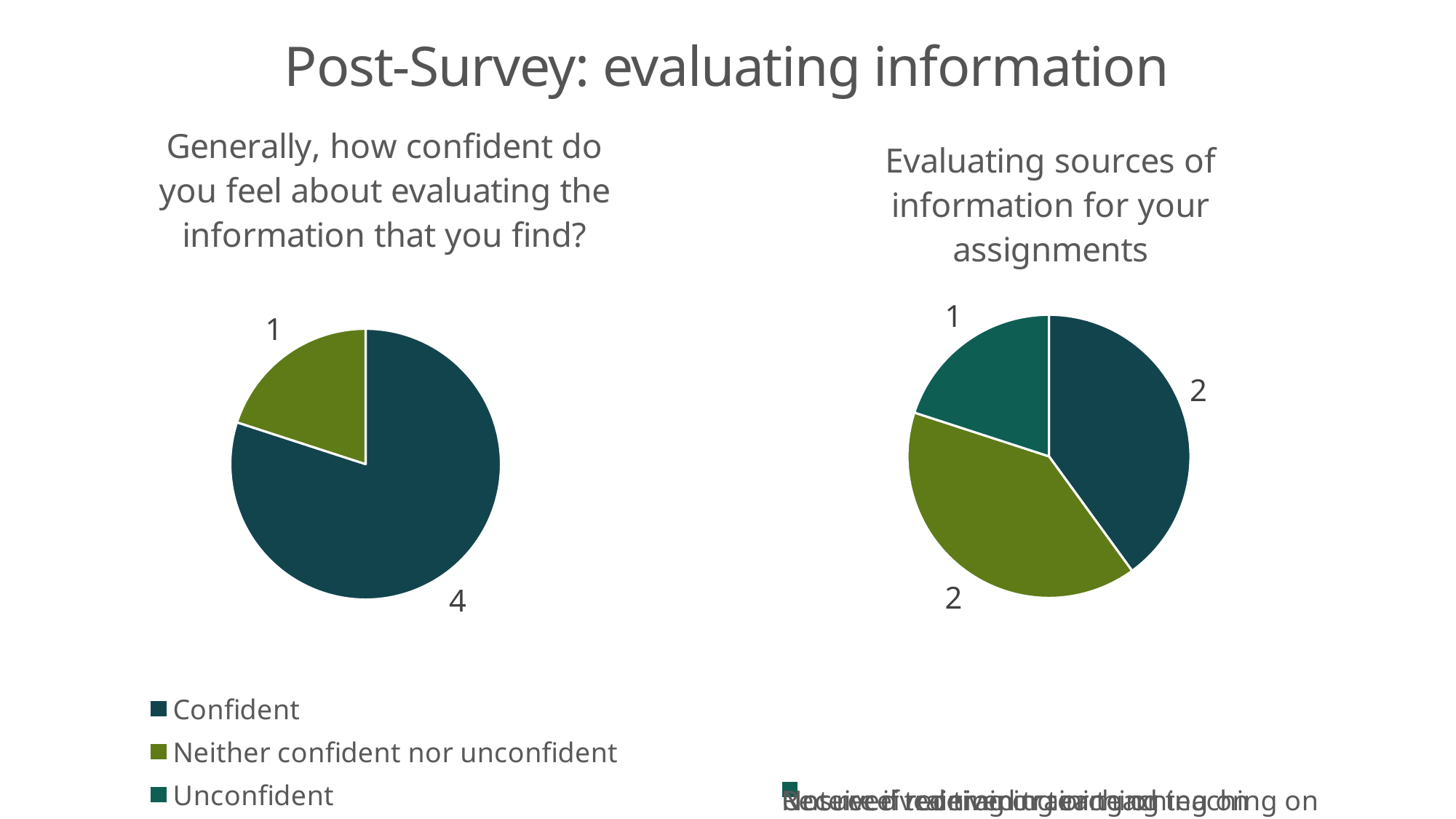
On the right pie chart titled 'Evaluating sources of information for your assignments', what is the total of all slice values? 5 On the left pie chart, how many respondents answered 'Neither confident nor unconfident'? 1 What is the title of the slide? Post-Survey: evaluating information On the left pie chart, what share of the total does the 'Confident' slice represent? 80% On the left pie chart, which is larger: 'Confident' or 'Neither confident nor unconfident'? Confident On the left pie chart, what is the difference between the 'Confident' and 'Neither confident nor unconfident' values? 3 How many entries does the legend of the left pie chart list? 3 On the right pie chart titled 'Evaluating sources of information for your assignments', how many slices are shown? 3 On the left pie chart, which category has the largest slice? Confident On the right pie chart titled 'Evaluating sources of information for your assignments', what is the value of the smallest slice? 1 What type of chart is used for 'Generally, how confident do you feel about evaluating the information that you find?' Pie chart On the left pie chart, how many respondents answered 'Confident'? 4